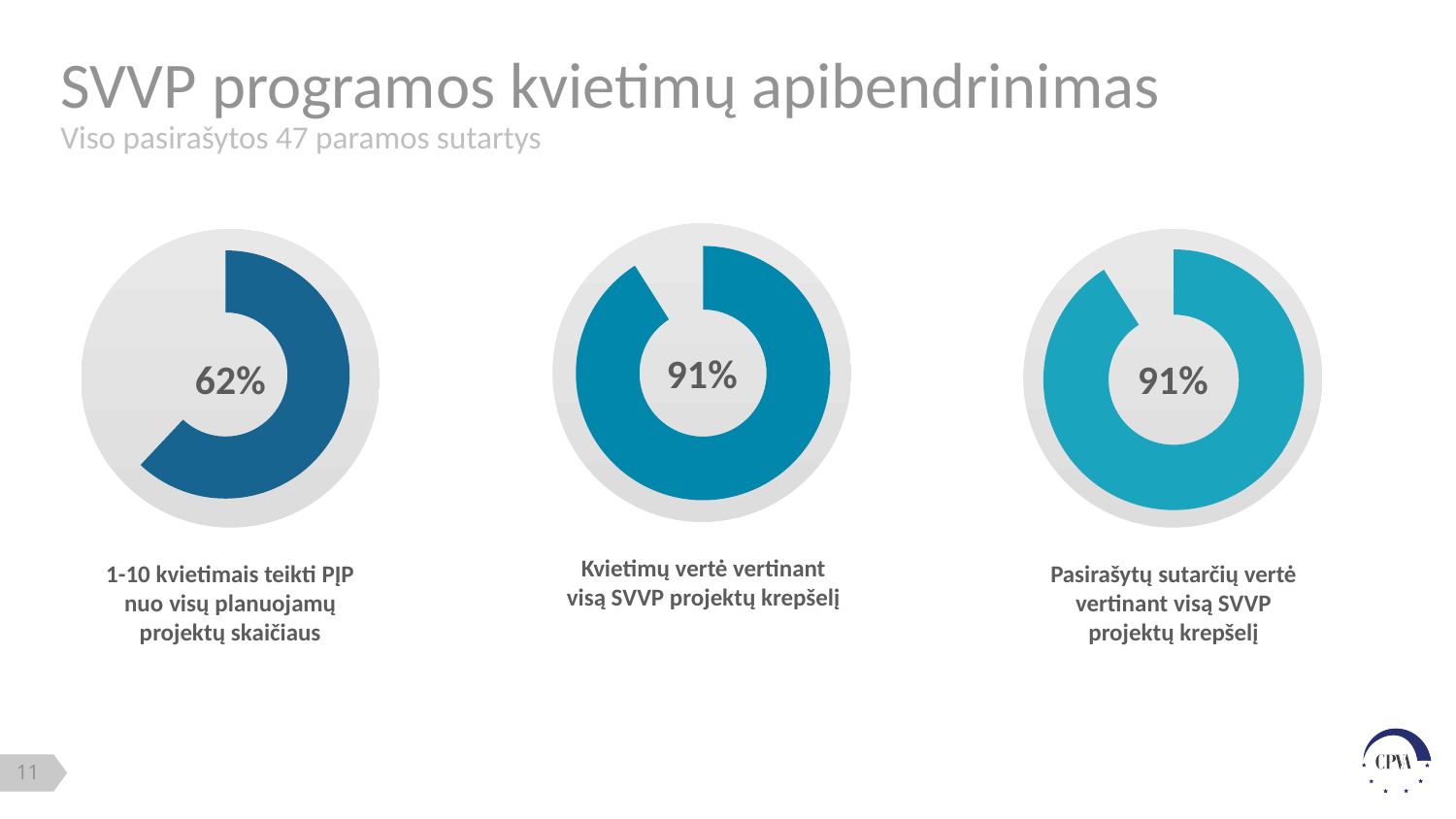
What is the title of the slide containing the three doughnut charts? SVVP programos kvietimų apibendrinimas What is the difference in percentage points between the middle chart's value and the left chart's value? 29 percentage points Do the middle and right charts show the same percentage? Yes, both show 91% According to the slide subtitle, how many support contracts were signed in total? 47 In the right chart (Pasirašytų sutarčių vertė vertinant visą SVVP projektų krepšelį), what percentage is shown? 91% In the left chart (1-10 kvietimais teikti PĮP nuo visų planuojamų projektų skaičiaus), what percentage is shown? 62% In the middle chart (Kvietimų vertė vertinant visą SVVP projektų krepšelį), what percentage is shown? 91% Which is larger: the value in the left chart (62%) or the value in the middle chart (91%)? The middle chart (91%) Which of the three charts shows the lowest percentage? 1-10 kvietimais teikti PĮP nuo visų planuojamų projektų skaičiaus (62%) Is the value in the left chart greater or less than 50%? greater How many doughnut charts are shown on the slide? 3 What kind of chart is used for the three figures on the slide? Doughnut chart